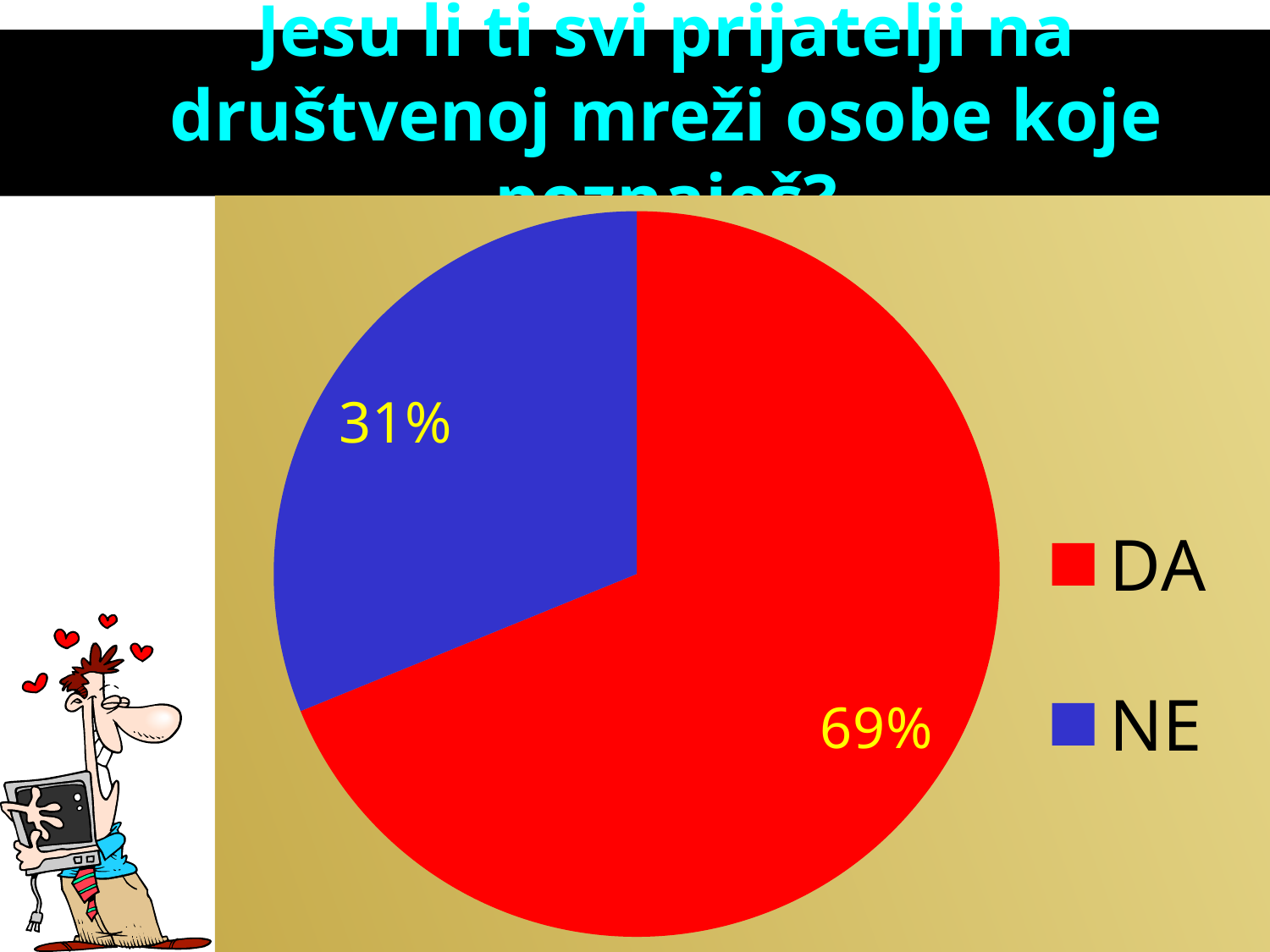
What percentage of the pie is labelled DA? 69% How many slices does the pie chart have? 2 What colour is the DA slice? red What kind of chart is shown on the slide? pie chart What colour is the NE slice? blue Which slice is the largest? DA Which slice is the smallest? NE What percentage of the pie is labelled NE? 31% What share of the pie does the NE slice represent? 31% What is the difference in percentage points between the DA and NE slices? 38 Which is larger, the DA slice or the NE slice? DA How many entries does the legend list? 2